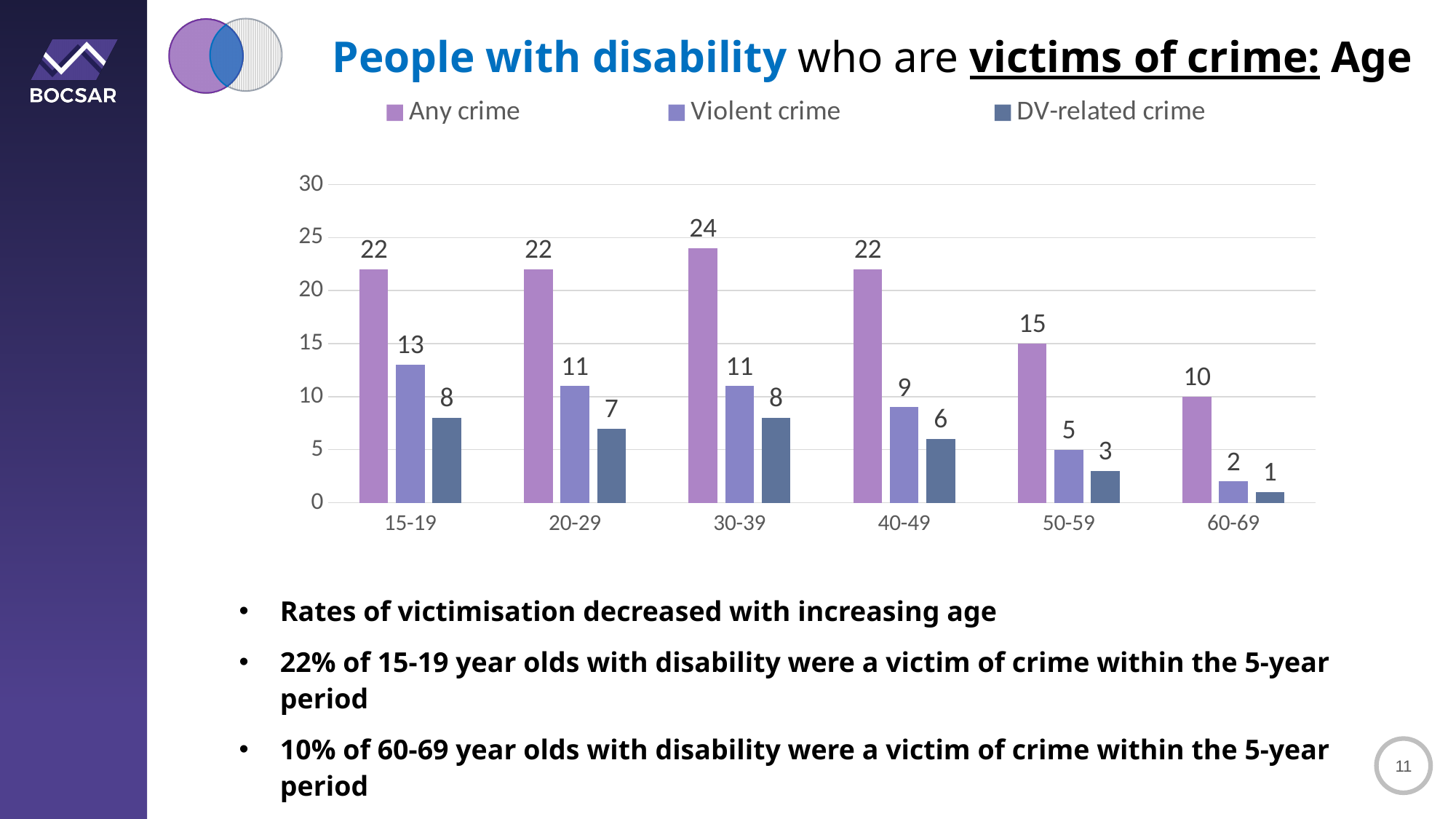
Which age group has the highest value for Any crime? 30-39 What is the value for DV-related crime in the 60-69 age group? 1 How many series does the legend list? 3 How many age groups are shown on the x axis? 6 What is the difference between the Any crime value for 15-19 and the Any crime value for 60-69? 12 Is the value for Any crime in the 50-59 age group greater or less than 20? less Which is larger: the Violent crime value for 40-49 or the DV-related crime value for 15-19? Violent crime for 40-49 What is the value for Violent crime in the 15-19 age group? 13 What kind of chart is shown on the slide? Bar chart Do the DV-related crime values rise or fall as age increases along the x axis? Fall Which age group has the lowest value for Violent crime? 60-69 What is the value for Any crime in the 30-39 age group? 24